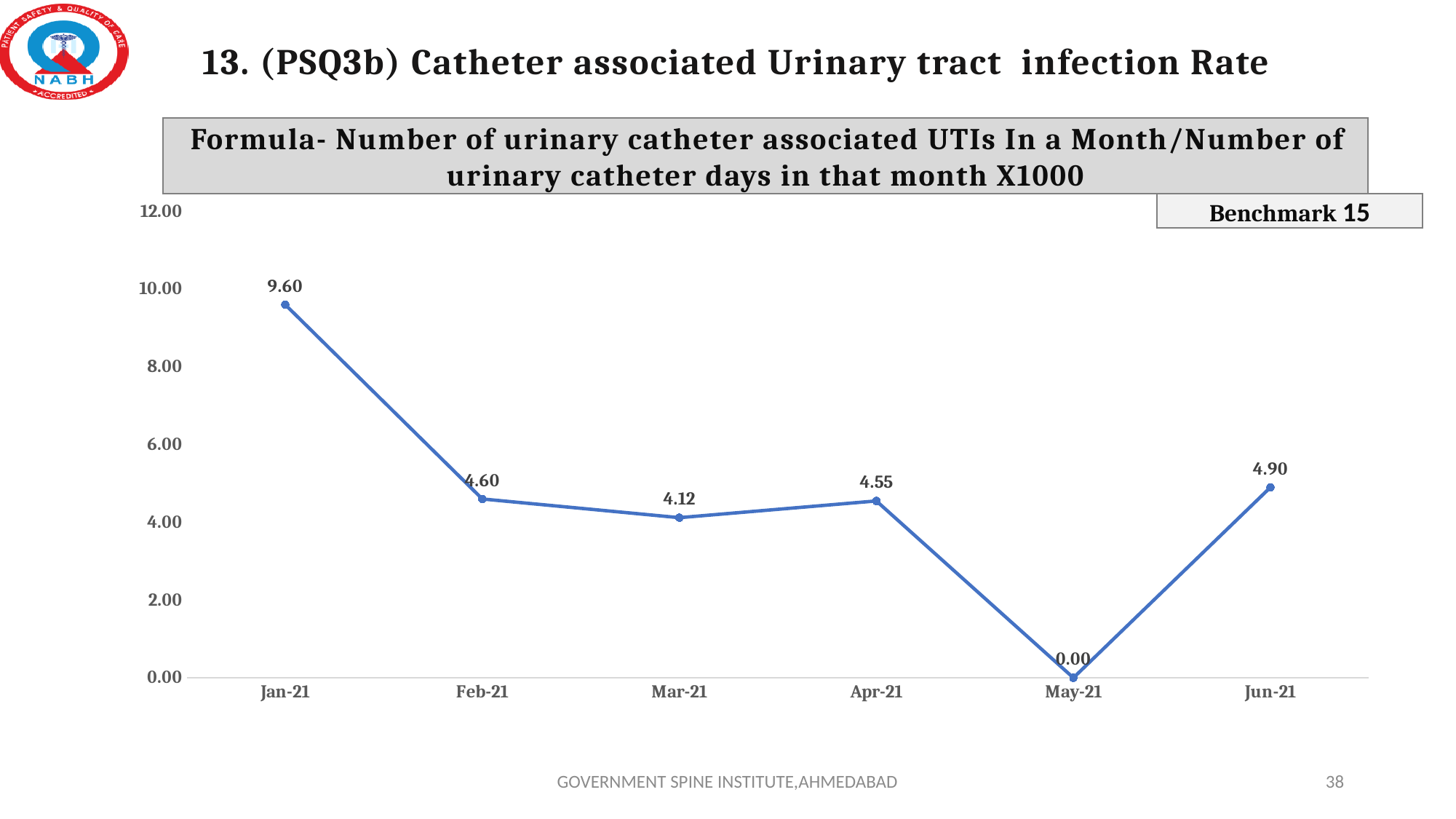
Which month has the lowest catheter associated UTI rate? May-21 Which is larger, the value for Feb-21 or the value for Jun-21? Jun-21 What is the catheter associated urinary tract infection rate for Jan-21? 9.60 What is the difference between the Jan-21 and Feb-21 values? 5.00 Which month has the highest catheter associated UTI rate? Jan-21 What kind of chart is shown on the slide? line chart Is the value for Jan-21 greater or less than 8.00? greater What is the value plotted for May-21? 0.00 What is the value plotted for Jun-21? 4.90 What benchmark value is stated on the slide? 15 What is the difference between the Apr-21 and Mar-21 values? 0.43 How many months are plotted on the chart? 6